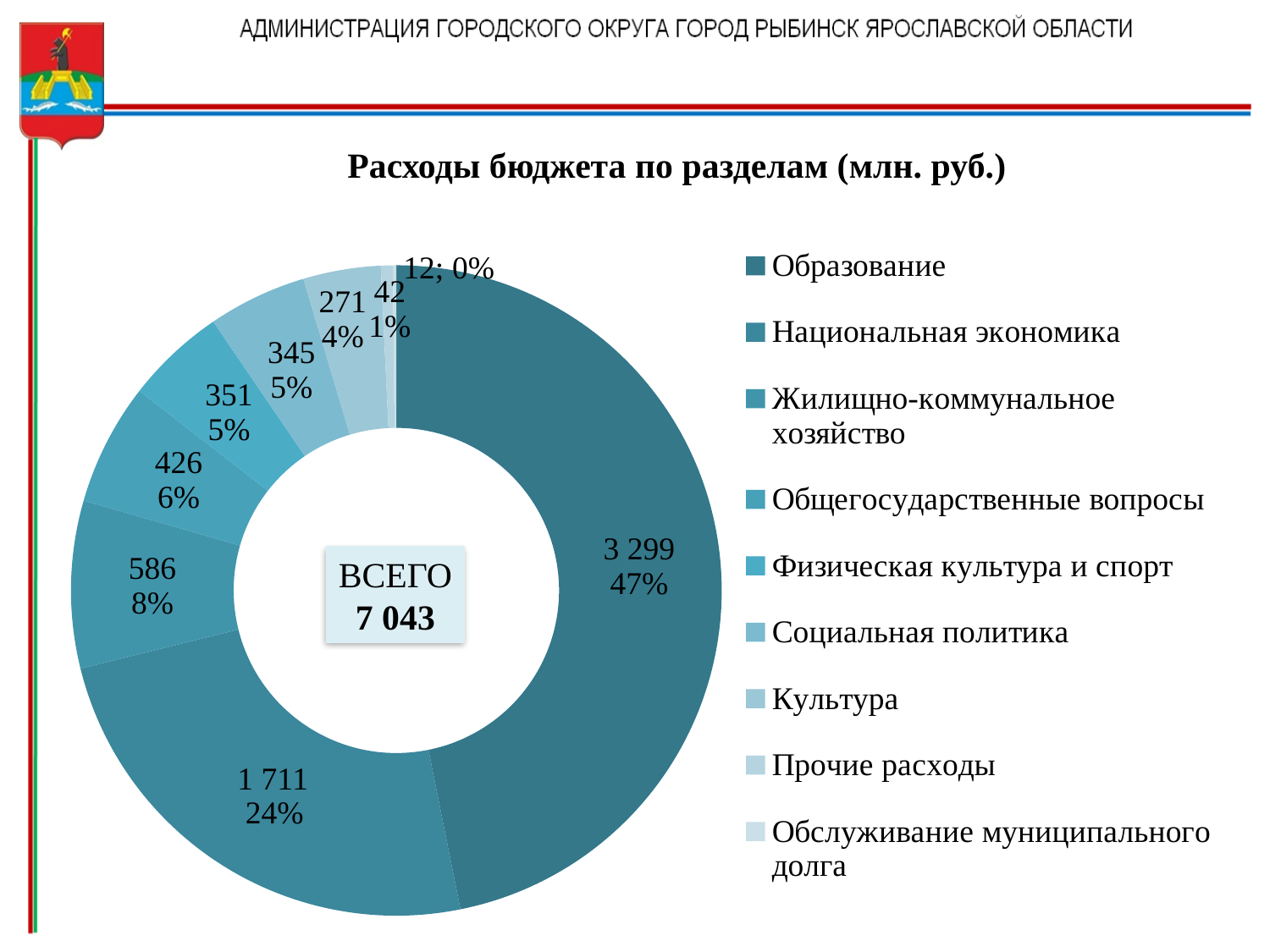
What is the difference between the values for Образование and Национальная экономика? 1 588 What total value is shown in the centre of the chart? 7 043 Which section has the lowest expenditure? Обслуживание муниципального долга How many sections (categories) does the chart show? 9 What share of the total does Общегосударственные вопросы account for? 6% What is the value for Жилищно-коммунальное хозяйство? 586 What type of chart is shown on the slide? Doughnut (pie) chart What is the value for Национальная экономика? 1 711 Which is larger: the value for Культура or the value for Социальная политика? Социальная политика What share of the total does Образование account for? 47% What is the value for Образование in the chart? 3 299 Which section has the highest expenditure? Образование